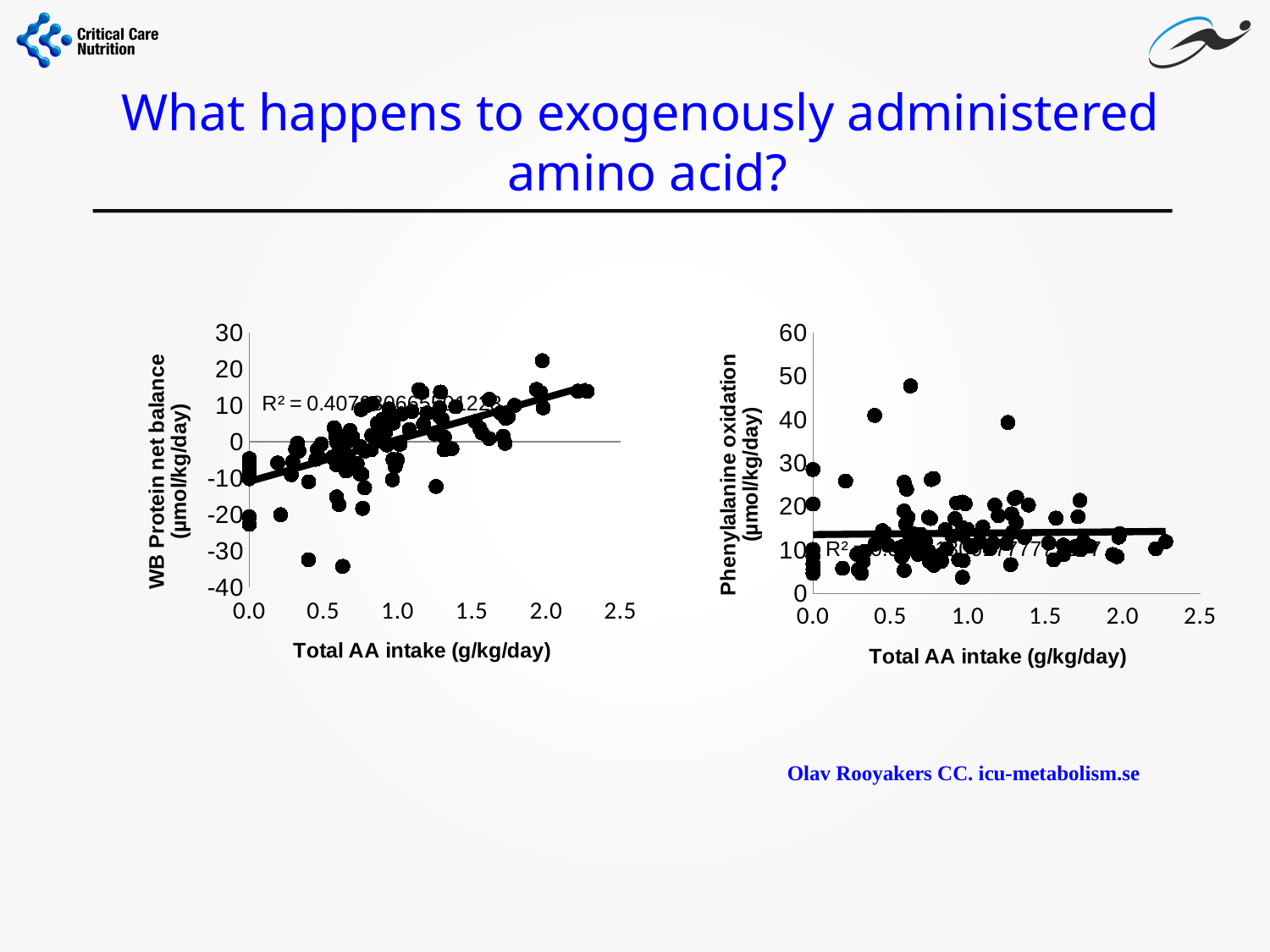
What kind of chart is the right chart (Phenylalanine oxidation)? scatter chart In the right chart, is the fitted trend line above or below 20 on the y axis? below Which chart has the steeper fitted trend line, the left chart or the right chart? the left chart In the left chart, what is the label of the x axis? Total AA intake (g/kg/day) In the right chart, does the fitted trend line rise, fall, or stay roughly flat as Total AA intake increases? roughly flat In the right chart, what is the label of the y axis? Phenylalanine oxidation (µmol/kg/day) What kind of chart is the left chart (WB Protein net balance)? scatter chart In the right chart, is the highest plotted point greater or less than 40? greater In the left chart, does the fitted trend line rise or fall as Total AA intake increases? rises In the left chart, is the highest plotted point greater or less than 20? greater How many charts are shown on the slide? 2